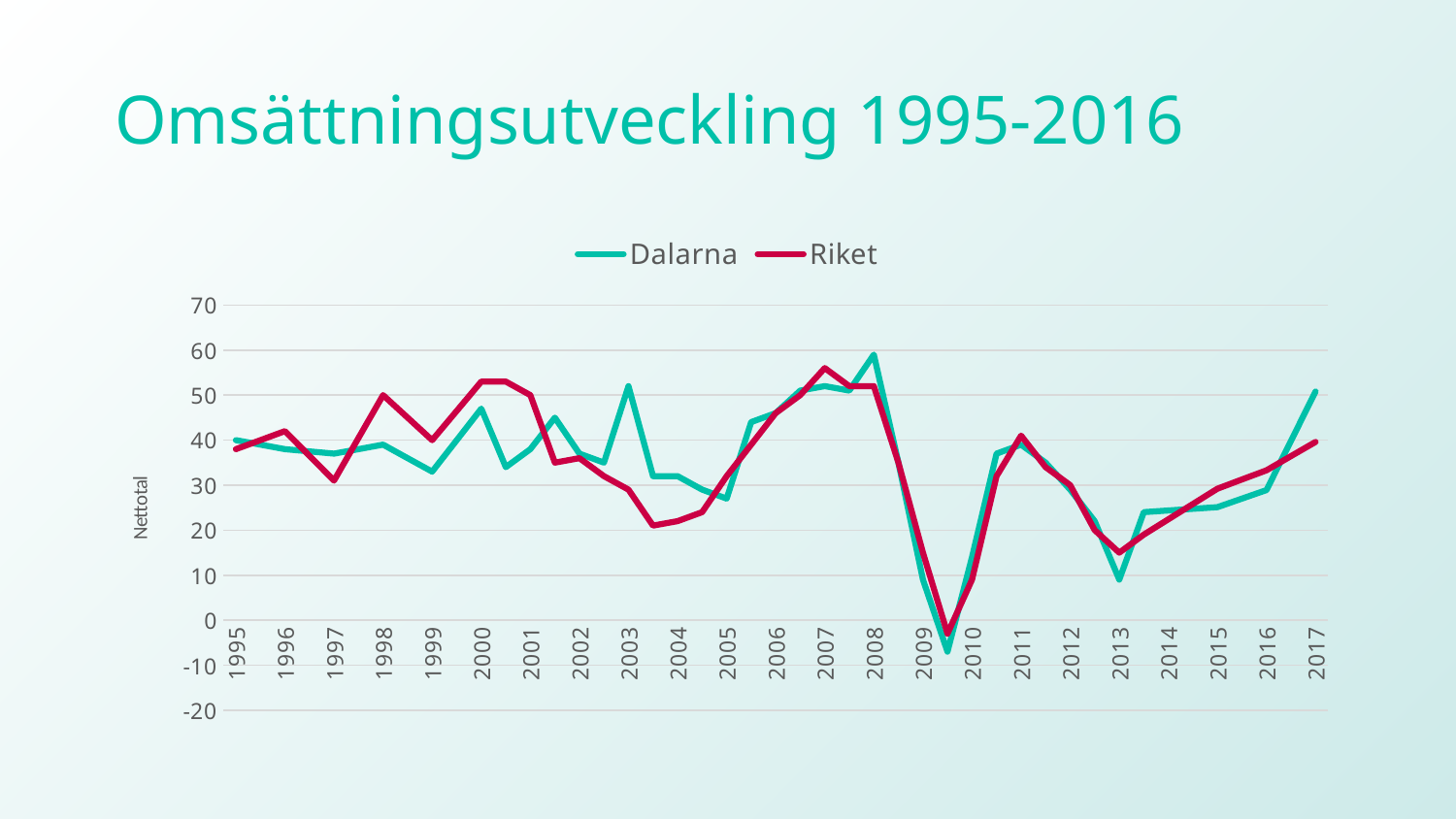
How many years are labelled on the x axis? 23 In 2003, which series has the higher value, Dalarna or Riket? Dalarna What is the label on the y axis? Nettotal What is the title of the chart? Omsättningsutveckling 1995-2016 What kind of chart is shown on the slide? line chart In which year does Dalarna reach its lowest value? 2009 How many series does the legend list? 2 Is the value for Riket in 2004 greater or less than 30? less In which year does Dalarna reach its highest value? 2008